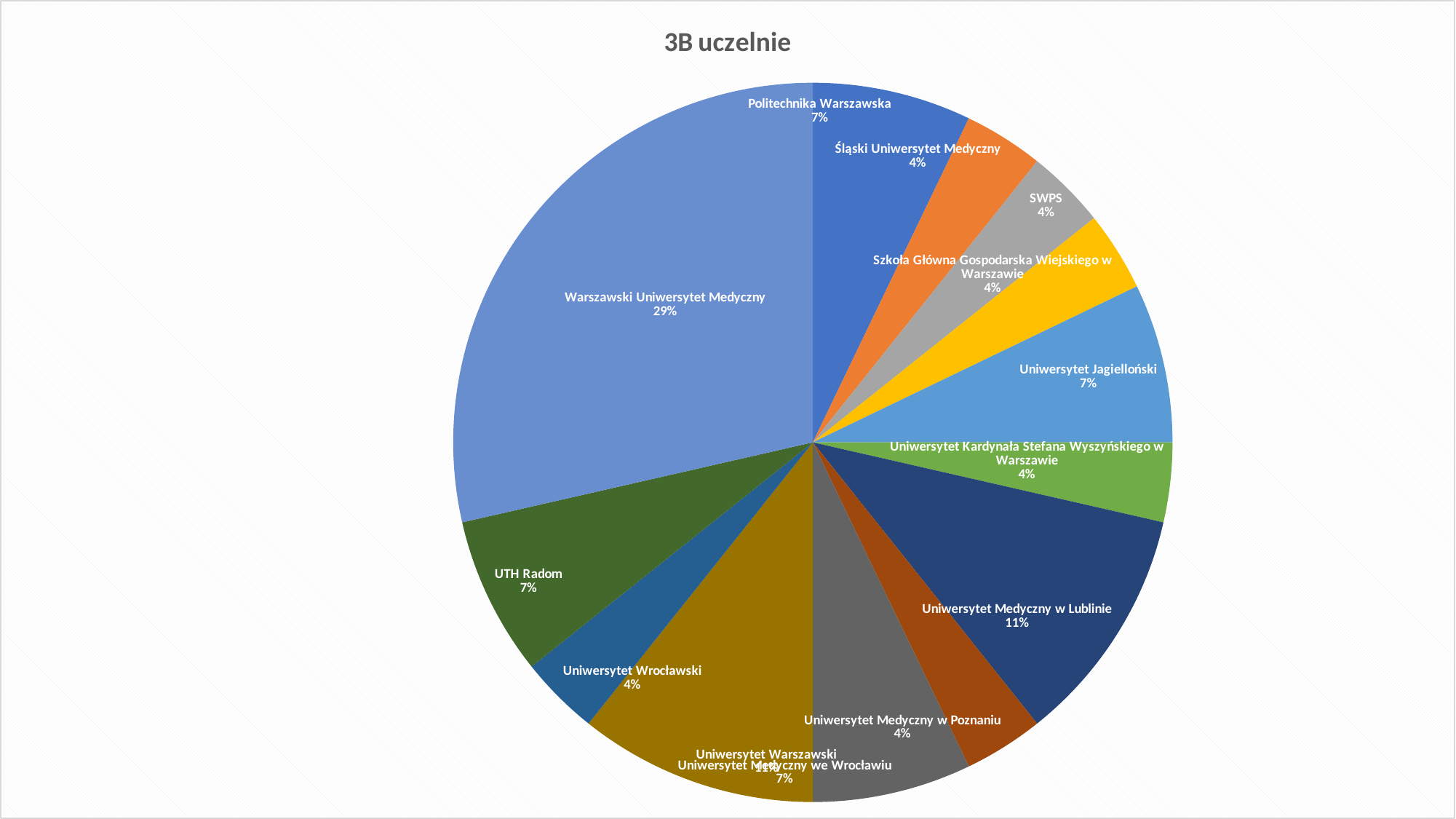
How many slices does the pie chart have? 13 Which is larger, the slice for Uniwersytet Medyczny w Lublinie or the slice for Uniwersytet Medyczny w Poznaniu? Uniwersytet Medyczny w Lublinie What type of chart is shown on the slide? pie chart What share of the pie does Uniwersytet Wrocławski have? 4% Which university has the largest slice of the pie? Warszawski Uniwersytet Medyczny What share of the pie does Uniwersytet Medyczny w Lublinie have? 11% What is the difference in percentage points between Warszawski Uniwersytet Medyczny and Politechnika Warszawska? 22 What is the title of the chart? 3B uczelnie What share of the pie does SWPS have? 4%